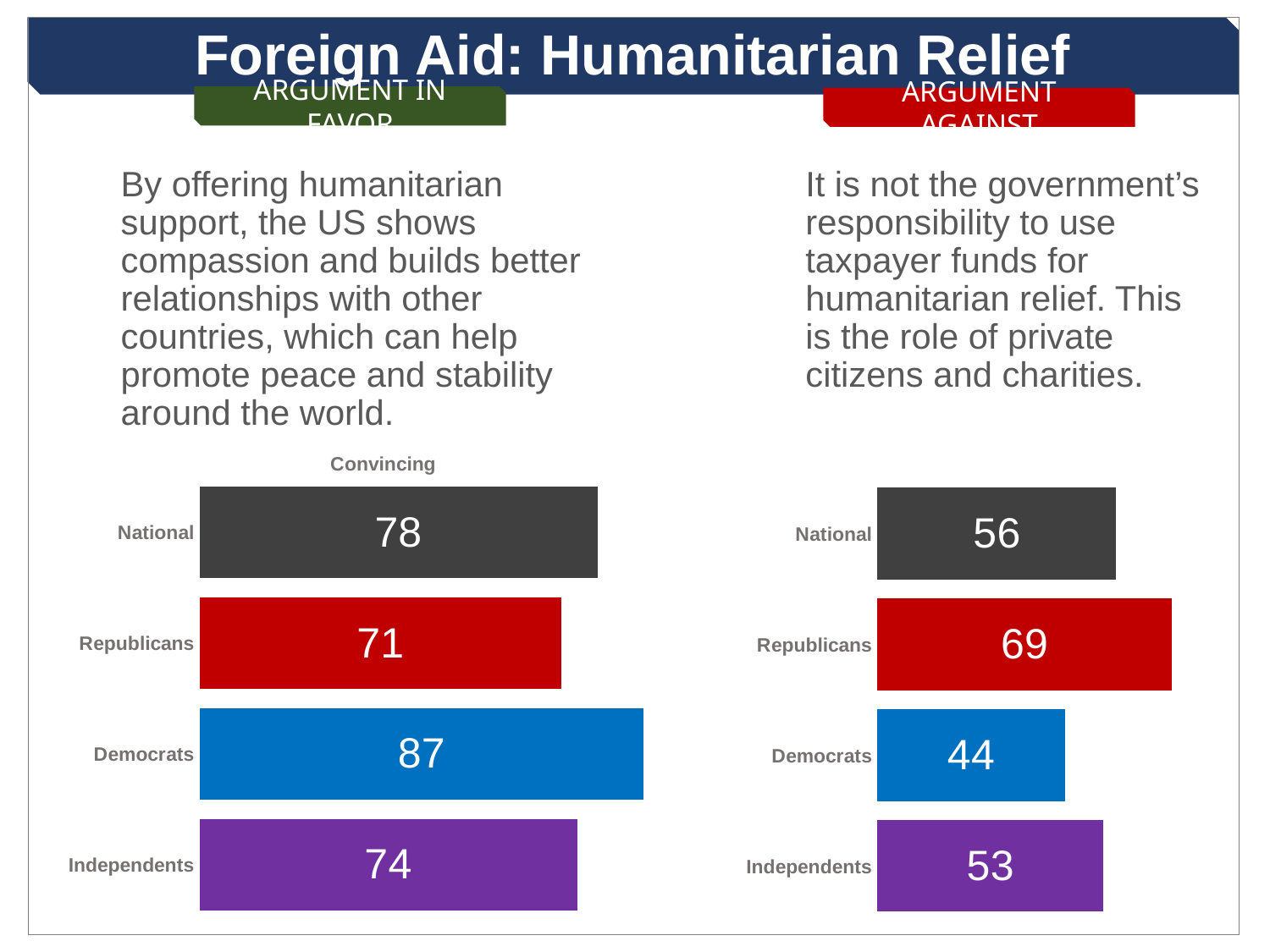
How many categories are shown in the left chart (Argument in Favor)? 4 In the right chart (Argument Against), what is the value for Independents? 53 In the left chart (Argument in Favor), what is the value for National? 78 In the right chart (Argument Against), which category has the highest value? Republicans In the left chart (Argument in Favor), which category has the highest value? Democrats What kind of chart is the right chart (Argument Against)? Bar chart In the left chart (Argument in Favor), what is the value for Republicans? 71 In the right chart (Argument Against), which category has the lowest value? Democrats In the right chart (Argument Against), what is the value for Democrats? 44 In the left chart (Argument in Favor), what is the difference between the Democrats value and the Republicans value? 16 Which is larger: the Independents value in the left chart (Argument in Favor) or the Independents value in the right chart (Argument Against)? Argument in Favor In the right chart (Argument Against), what is the difference between the National value and the Democrats value? 12